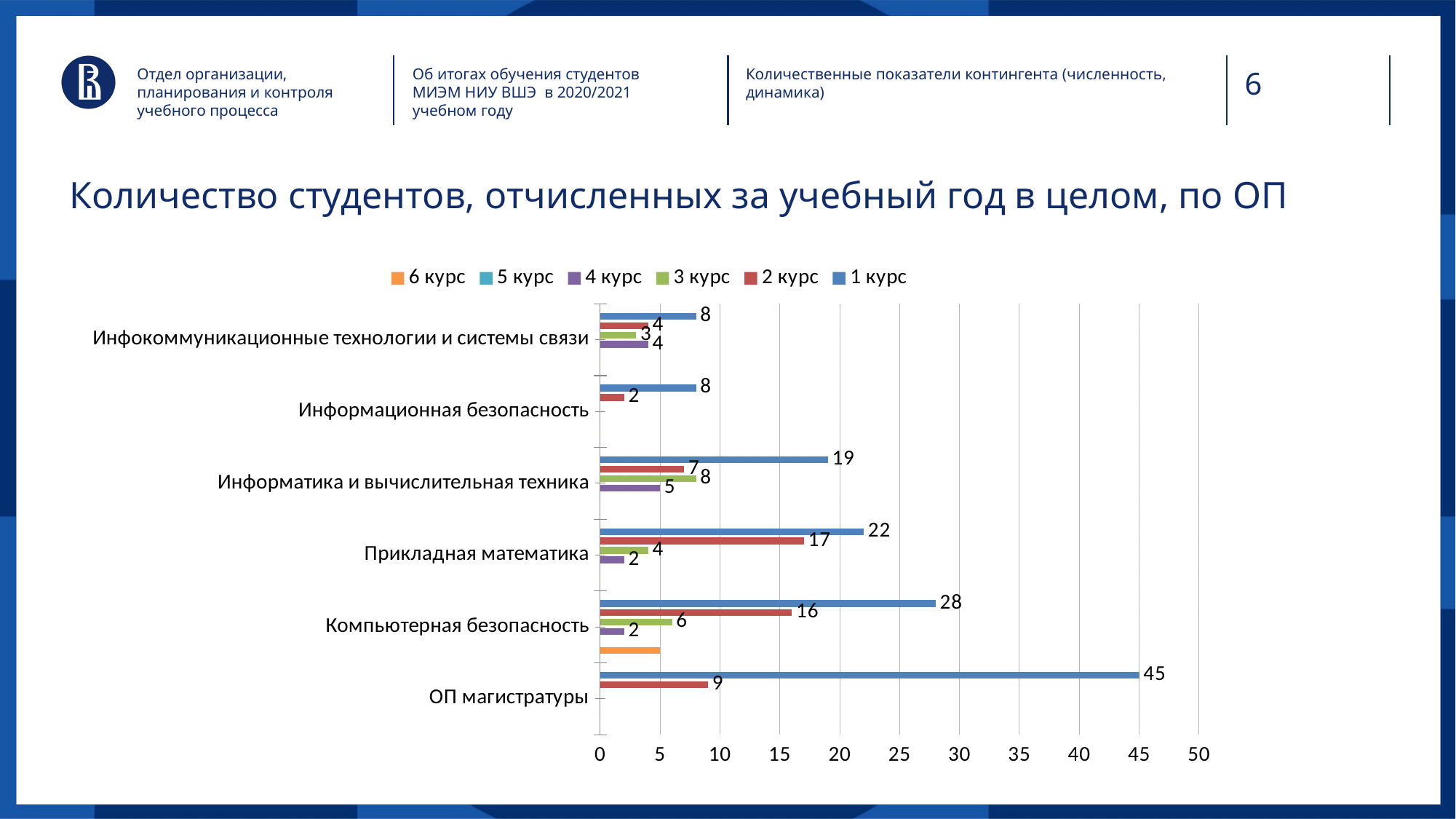
How many categories (educational programmes) are shown on the chart? 6 Is the value for 6 курс in the Компьютерная безопасность category greater or less than 10? less Which category has the highest value for 1 курс? ОП магистратуры What is the difference between the 1 курс values for Компьютерная безопасность and Прикладная математика? 6 How many series does the legend list? 6 What is the title of the chart? Количество студентов, отчисленных за учебный год в целом, по ОП What kind of chart is shown on the slide? bar chart What is the value for 2 курс in the Прикладная математика category? 17 What is the value for 1 курс in the ОП магистратуры category? 45 Which is larger: the 2 курс value for Компьютерная безопасность or the 2 курс value for Прикладная математика? Прикладная математика What is the value for 4 курс in the Информатика и вычислительная техника category? 5 Which category has the lowest value for 2 курс? Информационная безопасность